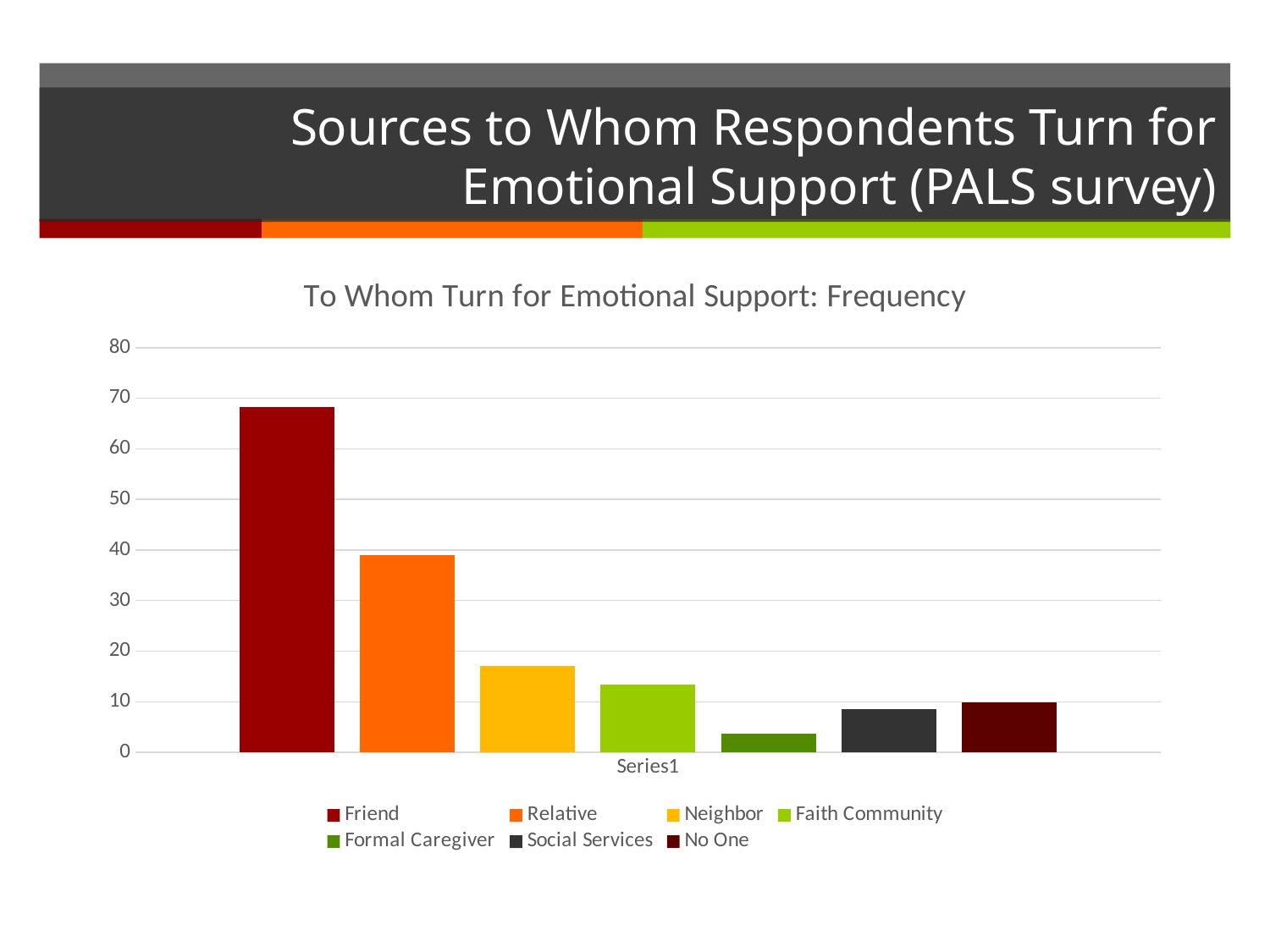
Which source has the lowest bar? Formal Caregiver Is the value for Friend greater or less than 60? greater What kind of chart is shown on the slide? bar chart Which source has the highest bar? Friend Which is larger, the value for Neighbor or the value for Faith Community? Neighbor What label appears under the bars on the x axis? Series1 Is the value for Neighbor greater or less than 20? less What is the title of the chart? To Whom Turn for Emotional Support: Frequency How many entries does the legend list? 7 Which is larger, the value for Friend or the value for Relative? Friend Is the value for Formal Caregiver greater or less than 10? less